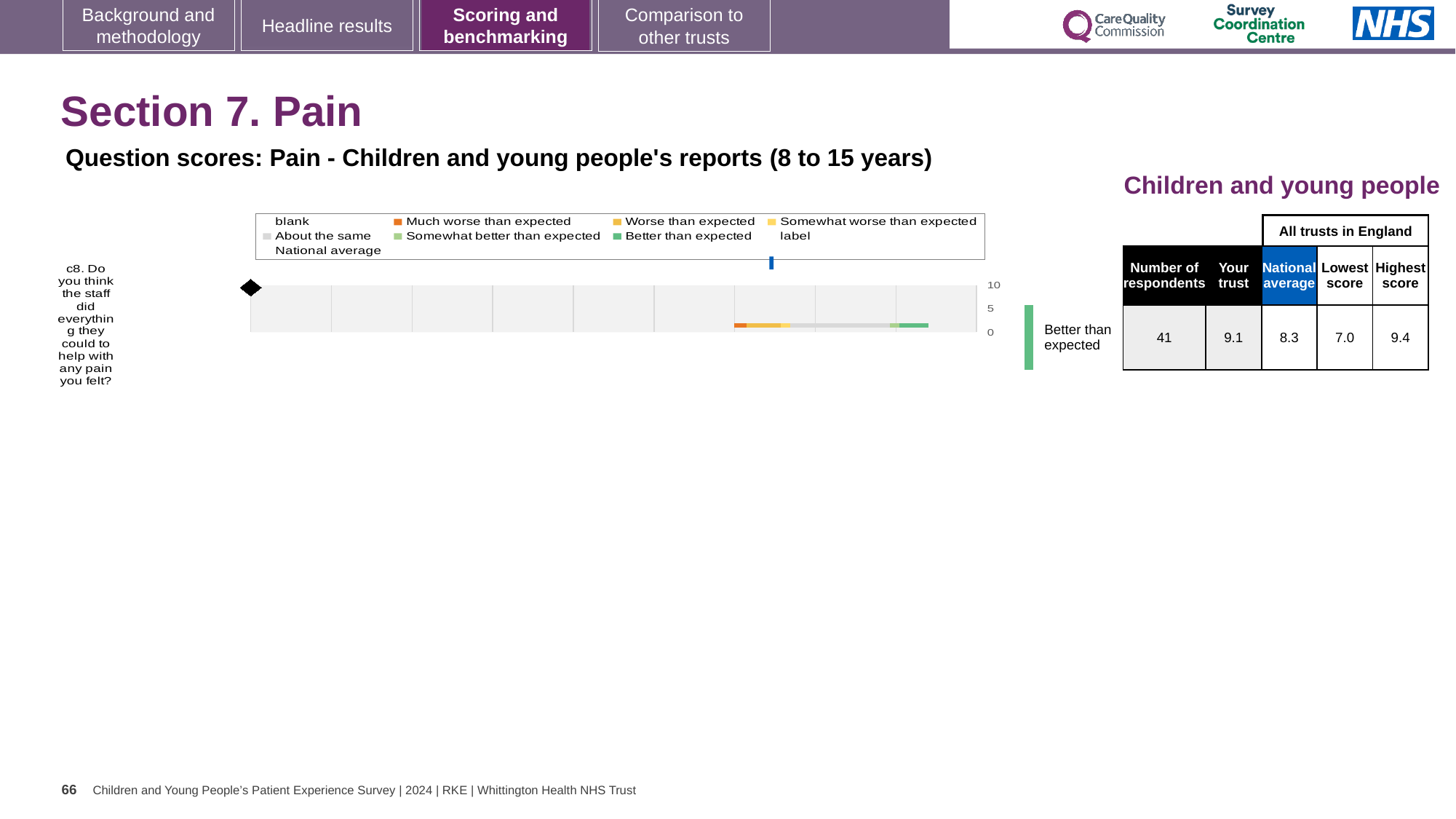
What is the national average score for question c8? 8.3 How many respondents answered question c8? 41 What is the lowest score among all trusts in England for question c8? 7.0 Which survey question is plotted in the chart? c8. Do you think the staff did everything they could to help with any pain you felt? What is the highest score among all trusts in England for question c8? 9.4 What kind of chart is used to show the question score for c8? bar chart By how much does the 'Your trust' score exceed the national average for question c8? 0.8 What benchmark category is shown for question c8? Better than expected Which is higher for question c8: the 'Your trust' score or the national average? Your trust What is the difference between the highest and lowest scores for question c8? 2.4 What is the 'Your trust' score for question c8? 9.1 How many survey questions are plotted in the chart? 1